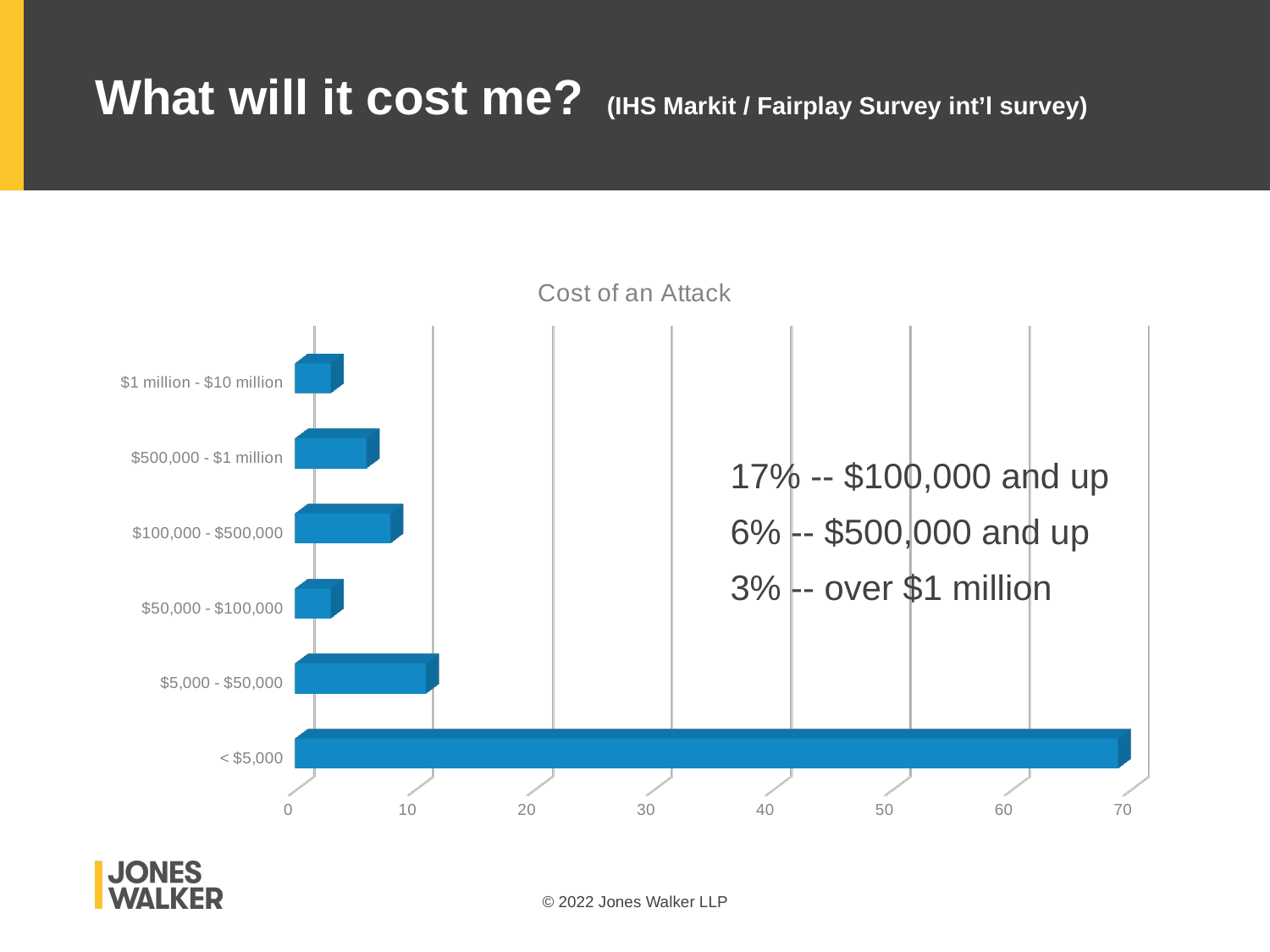
How many cost categories are plotted in the chart? 6 Is the value for $5,000 - $50,000 greater or less than 20? less What is the title of the chart? Cost of an Attack Is the value for $1 million - $10 million greater or less than 10? less Which is larger, the value for $5,000 - $50,000 or the value for $100,000 - $500,000? $5,000 - $50,000 Which cost category has the highest value in the chart? < $5,000 What type of chart is shown on the slide? bar chart Which is larger, the value for $100,000 - $500,000 or the value for $500,000 - $1 million? $100,000 - $500,000 What is the highest value shown on the horizontal axis of the chart? 70 Is the value for < $5,000 greater or less than 60? greater Which is larger, the value for < $5,000 or the value for $5,000 - $50,000? < $5,000